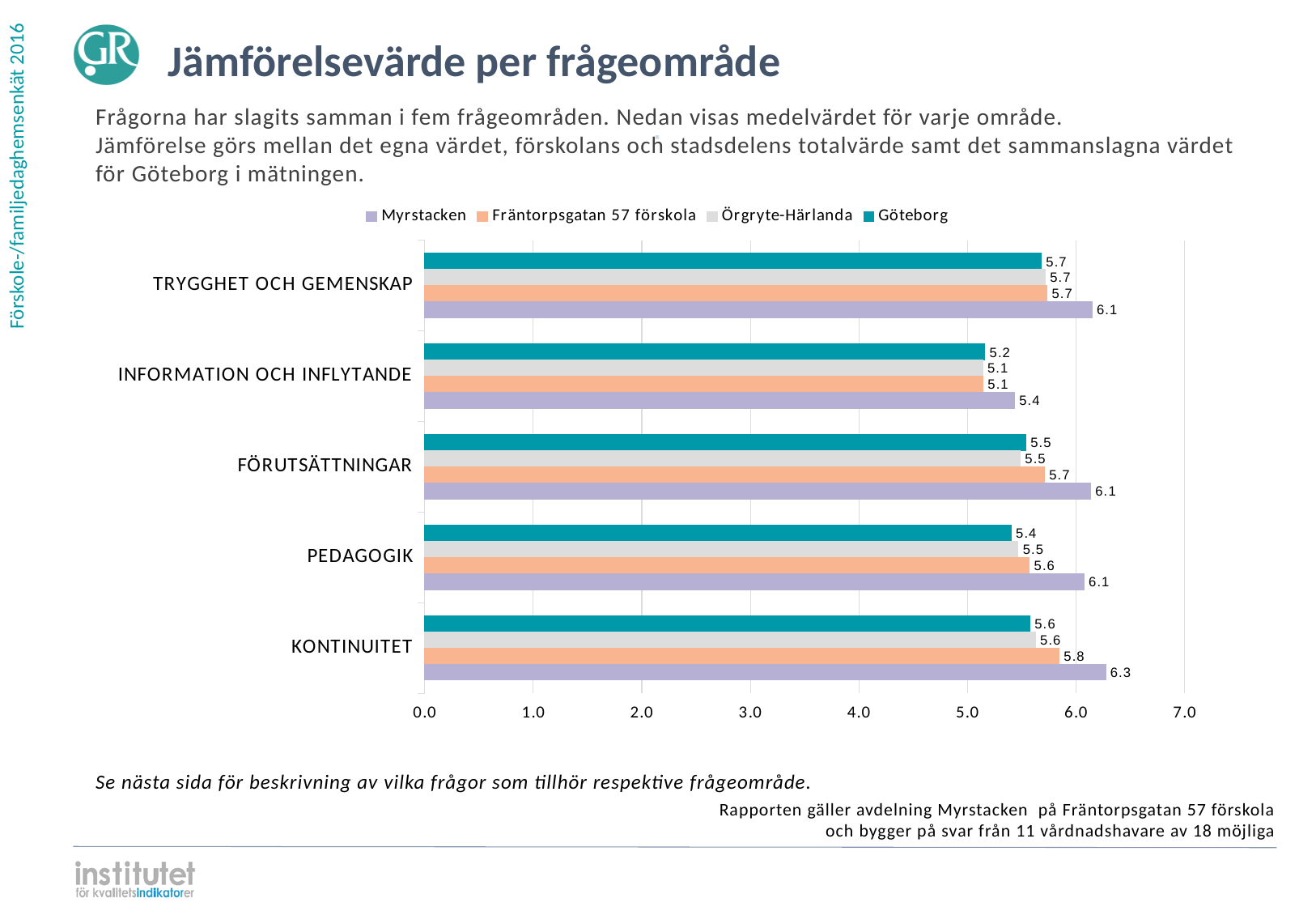
Which series is shown in purple in the legend? Myrstacken What is the value for Myrstacken in the KONTINUITET category? 6.3 How many categories (question areas) are shown on the chart? 5 In the KONTINUITET category, which is larger: the value for Fräntorpsgatan 57 förskola or the value for Göteborg? Fräntorpsgatan 57 förskola What is the value for Fräntorpsgatan 57 förskola in the PEDAGOGIK category? 5.6 What is the value for Örgryte-Härlanda in the FÖRUTSÄTTNINGAR category? 5.5 What is the difference between the Myrstacken value and the Göteborg value in the PEDAGOGIK category? 0.7 What is the value for Göteborg in the INFORMATION OCH INFLYTANDE category? 5.2 What kind of chart is shown on the slide? Bar chart In which category does Myrstacken have its lowest value? INFORMATION OCH INFLYTANDE In which category does Myrstacken have its highest value? KONTINUITET How many series does the legend list? 4